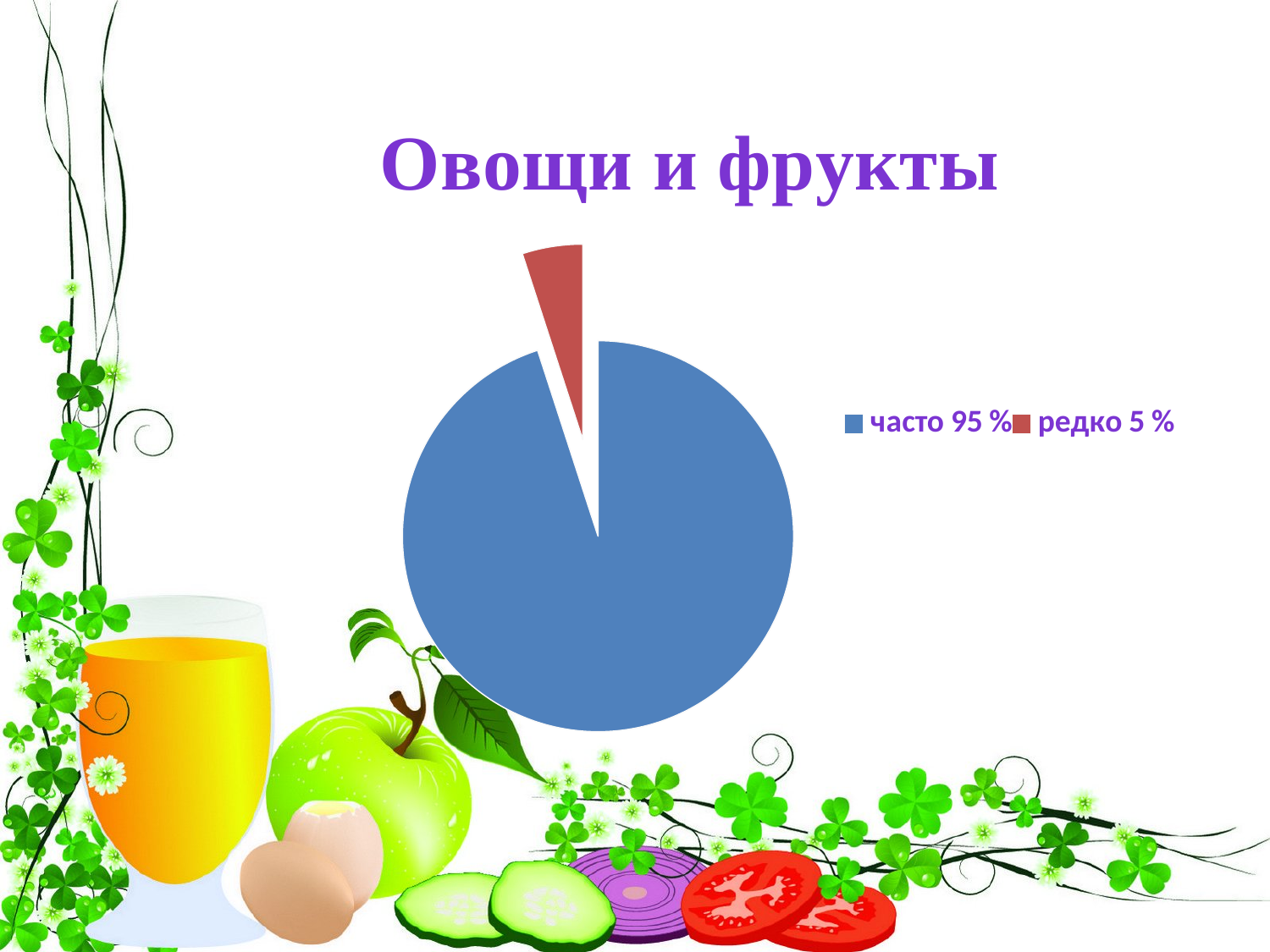
Which slice of the pie chart is the largest? часто 95 % What is the title of the slide with the pie chart? Овощи и фрукты What percentage is shown for "часто" in the pie chart legend? 95 % How many entries does the legend of the pie chart list? 2 Which slice of the pie chart is the smallest? редко 5 % What colour is the "редко" slice in the pie chart? red What is the difference in percentage points between "часто" and "редко" in the pie chart? 90 What percentage is shown for "редко" in the pie chart legend? 5 % Is the value for "часто" in the pie chart greater or less than 50 %? greater Which is larger in the pie chart, "часто" or "редко"? часто How many slices does the pie chart have? 2 What kind of chart is shown on the slide? pie chart